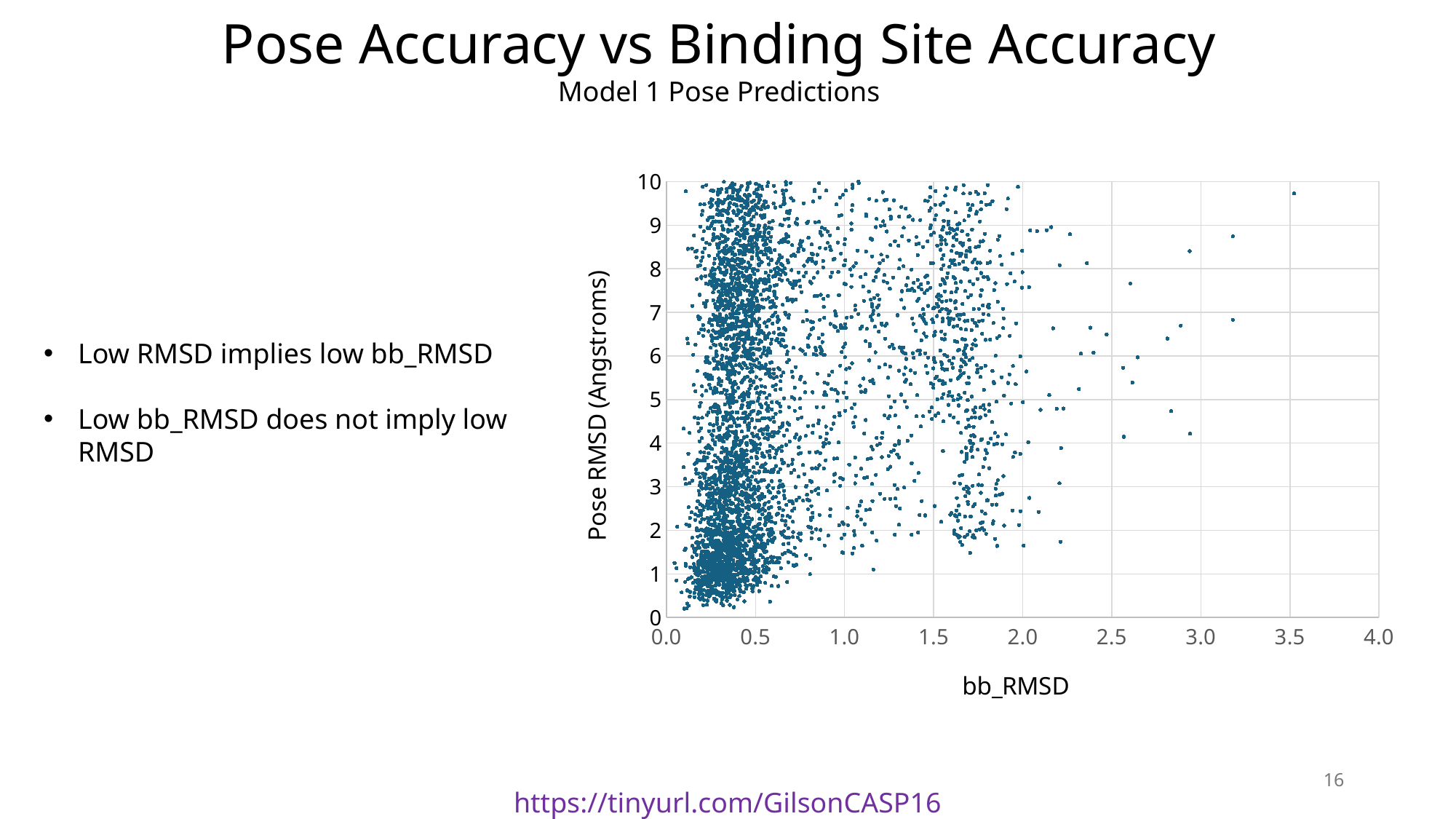
What is the highest tick value shown on the y axis? 10 What is the label of the y axis of the chart? Pose RMSD (Angstroms) What is the highest tick value shown on the x axis? 4.0 How many data series are plotted in the chart? 1 What kind of chart is shown on the slide? scatter plot What is the label of the x axis of the chart? bb_RMSD Is the bb_RMSD of the densest cluster of points greater or less than 1.0? less Is the bb_RMSD of the rightmost point in the chart greater or less than 3.0? greater Is the Pose RMSD of the rightmost point in the chart greater or less than 9? greater